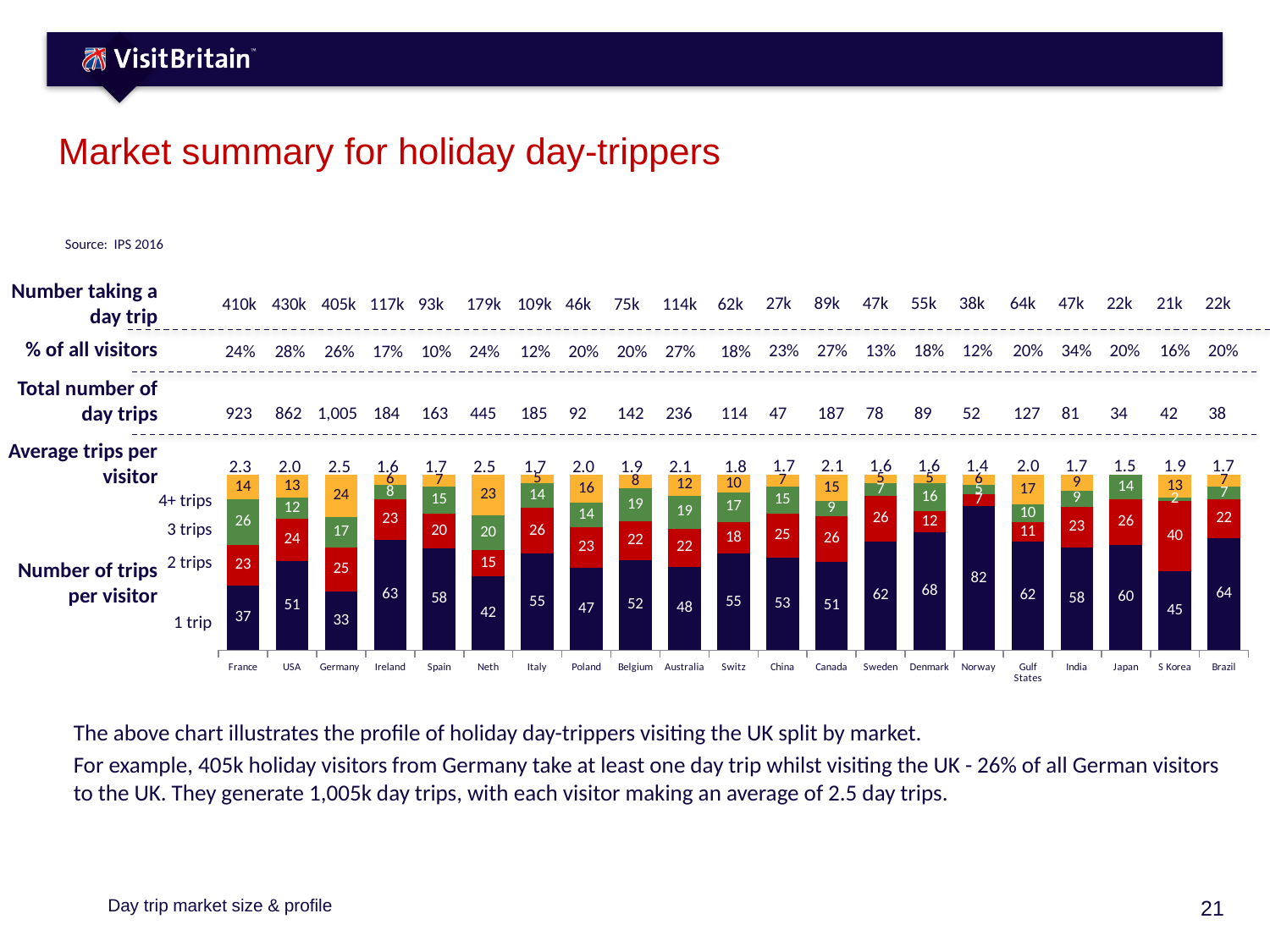
What is the value of the '3 trips' segment for Neth? 20 Which market has the highest '1 trip' value? Norway Which market has the lowest '1 trip' value? Germany What kind of chart is shown on the slide? Stacked bar chart Which has the larger '2 trips' value, S Korea or USA? S Korea How many markets are shown along the x axis of the chart? 21 What is the difference between the '1 trip' values for France and Germany? 4 What is the value of the '4+ trips' segment for Germany? 24 How many series (trip categories) are stacked in each bar? 4 What is the title of the slide containing the chart? Market summary for holiday day-trippers What is the value of the '1 trip' segment for Norway? 82 What is the total of the stacked bar for France? 100